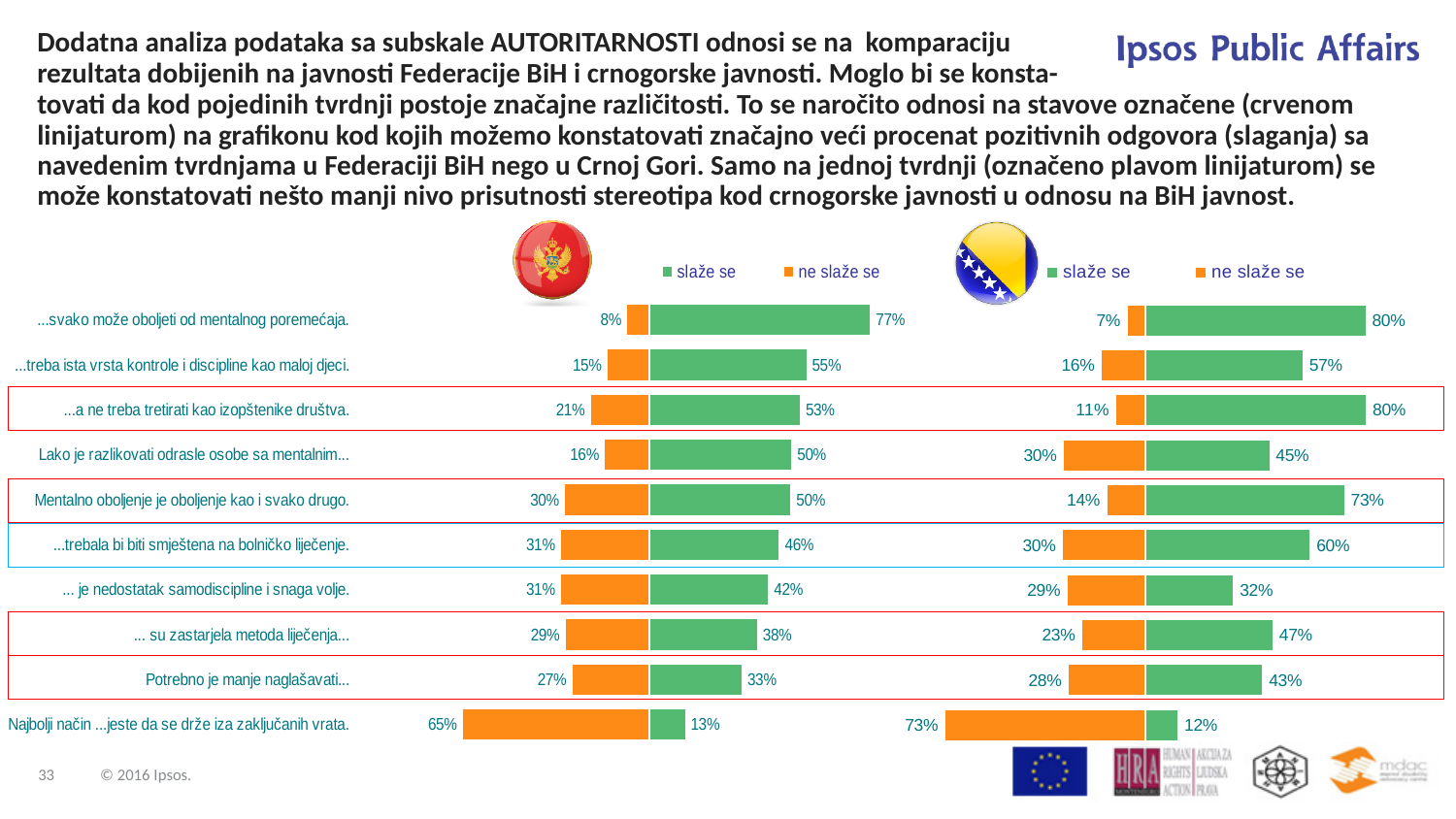
How many series does the legend of the right chart (Bosnian flag) list? 2 How many statements (categories) are plotted on the left chart (Montenegrin flag)? 10 For "... je nedostatak samodiscipline i snaga volje.", is the "slaže se" value larger on the left chart (Montenegrin flag) or on the right chart (Bosnian flag)? Left chart (Montenegrin flag) On the left chart (Montenegrin flag), what percentage is shown for "slaže se" for "...svako može oboljeti od mentalnog poremećaja."? 77% What type of chart is used on the left chart (Montenegrin flag)? Bar chart On the right chart (Bosnian flag), which statement has the lowest "slaže se" percentage? Najbolji način ...jeste da se drže iza zaključanih vrata. What is the difference between the "slaže se" values for "...a ne treba tretirati kao izopštenike društva." on the right chart (Bosnian flag) and on the left chart (Montenegrin flag)? 27 percentage points On the right chart (Bosnian flag), which colour represents "ne slaže se"? Orange On the right chart (Bosnian flag), what is the "slaže se" value for "Mentalno oboljenje je oboljenje kao i svako drugo."? 73% On the left chart (Montenegrin flag), what is the total of the "slaže se" and "ne slaže se" values for "Potrebno je manje naglašavati..."? 60% On the right chart (Bosnian flag), what percentage is shown for "ne slaže se" for "Lako je razlikovati odrasle osobe sa mentalnim..."? 30% On the left chart (Montenegrin flag), which statement has the highest "ne slaže se" percentage? Najbolji način ...jeste da se drže iza zaključanih vrata.